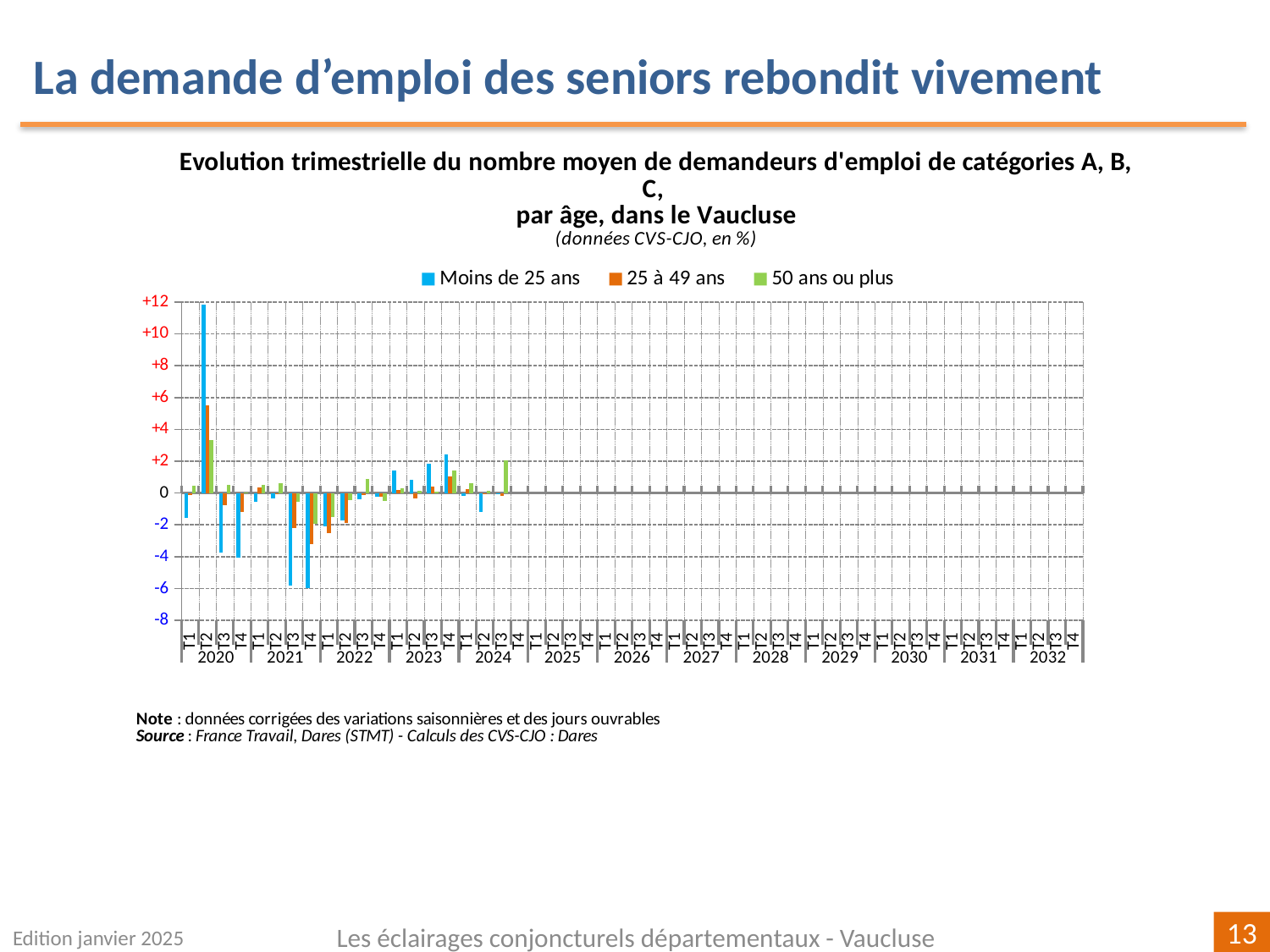
What kind of chart is shown on the slide? Bar chart In which quarter does the 'Moins de 25 ans' series reach its highest value? T2 2020 How many series does the legend list? 3 Is the value for 'Moins de 25 ans' in T3 2021 greater or less than -4? less In T2 2020, which is larger: the value for '25 à 49 ans' or for '50 ans ou plus'? 25 à 49 ans How many years are labelled along the x axis? 13 Is the value for '25 à 49 ans' in T2 2020 greater or less than +4? greater Is the value for 'Moins de 25 ans' in T3 2020 greater or less than -2? less Which series has the highest bar on the chart? Moins de 25 ans Which colour represents the '50 ans ou plus' series in the legend? Green In T2 2020, which is larger: the value for 'Moins de 25 ans' or for '25 à 49 ans'? Moins de 25 ans